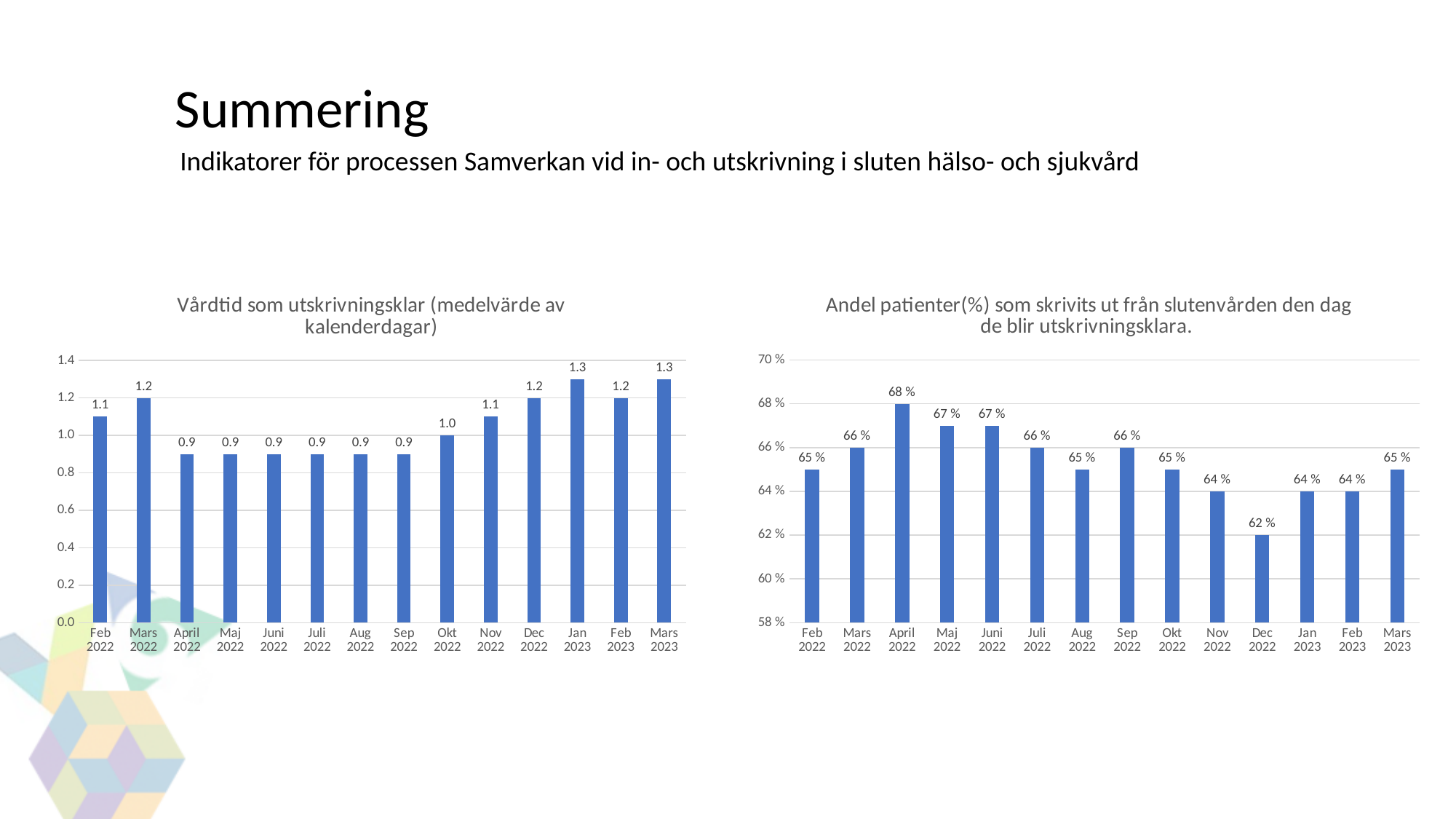
In the left chart (Vårdtid som utskrivningsklar), what is the value for Mars 2022? 1.2 In the left chart (Vårdtid som utskrivningsklar), which is larger, the value for Feb 2022 or the value for Dec 2022? Dec 2022 How many months are shown on the x axis of the left chart (Vårdtid som utskrivningsklar)? 14 In the right chart (Andel patienter som skrivits ut), is the value for Maj 2022 greater or less than 66 %? greater In the left chart (Vårdtid som utskrivningsklar), do the values rise or fall from Sep 2022 to Jan 2023? rise In the right chart (Andel patienter som skrivits ut), what is the value for Dec 2022? 62 % In the right chart (Andel patienter som skrivits ut), which month has the lowest value? Dec 2022 What kind of chart is the right chart (Andel patienter som skrivits ut)? bar chart In the right chart (Andel patienter som skrivits ut), which month has the highest value? April 2022 In the right chart (Andel patienter som skrivits ut), what is the difference between the values for April 2022 and Nov 2022? 4 % In the left chart (Vårdtid som utskrivningsklar), what is the value for Okt 2022? 1.0 In the left chart (Vårdtid som utskrivningsklar), what is the difference between the values for Jan 2023 and Sep 2022? 0.4